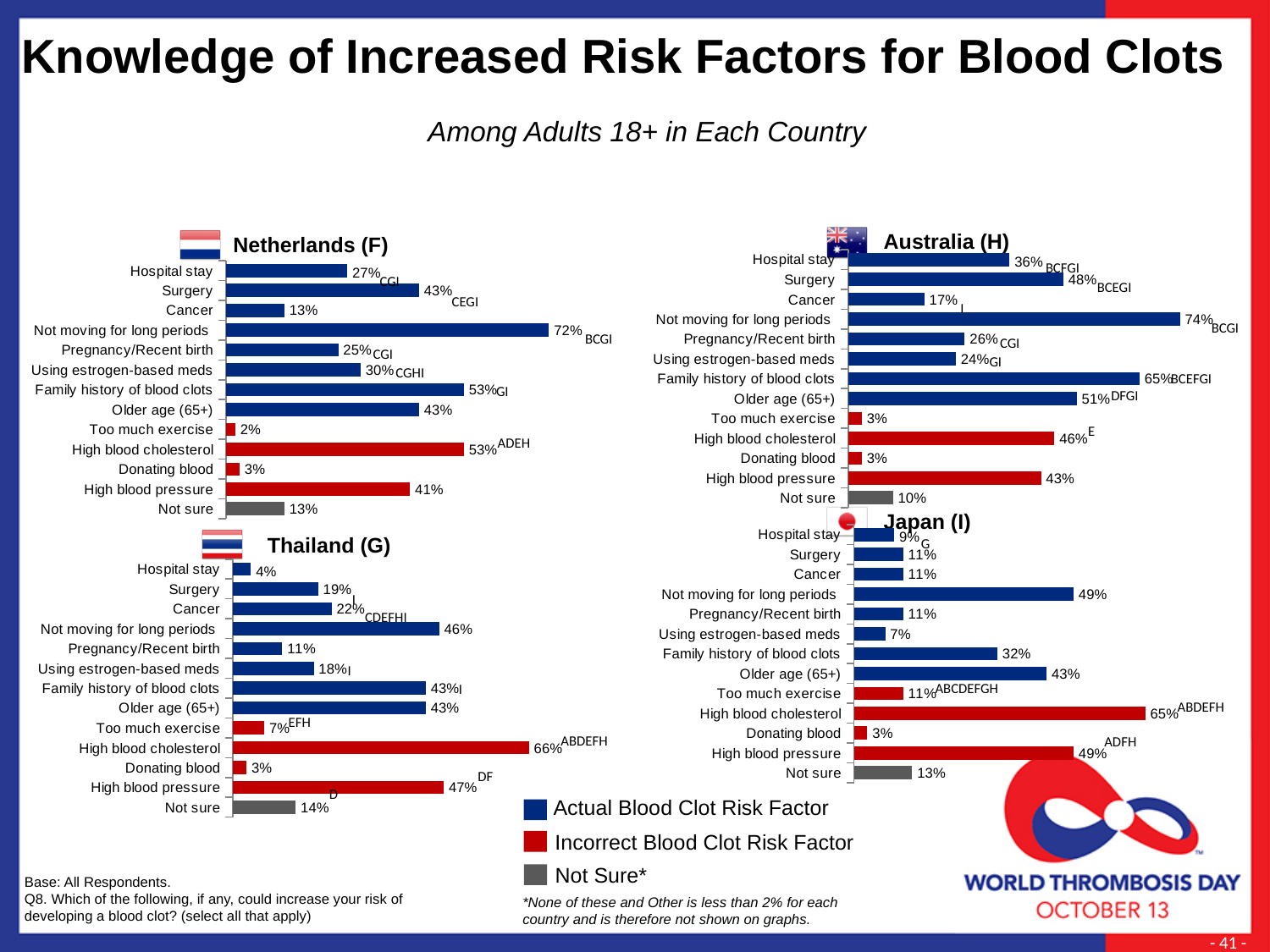
In the Netherlands (F) chart, what percentage is shown for Not moving for long periods? 72% In the Thailand (G) chart, which category has the highest value? High blood cholesterol In the Thailand (G) chart, which category has the lowest value? Donating blood What colour represents Incorrect Blood Clot Risk Factor in the legend? Red In the Netherlands (F) chart, what is the difference between Surgery and Cancer? 30 percentage points In the Japan (I) chart, what is the difference between High blood cholesterol and Not moving for long periods? 16 percentage points How many categories are plotted in the Japan (I) chart? 13 What type of chart is used for Netherlands (F)? Bar chart In the Australia (H) chart, which is larger: Surgery or High blood cholesterol? Surgery How many entries does the legend list? 3 In the Australia (H) chart, what is the value for Family history of blood clots? 65% In the Japan (I) chart, what percentage is shown for Older age (65+)? 43%